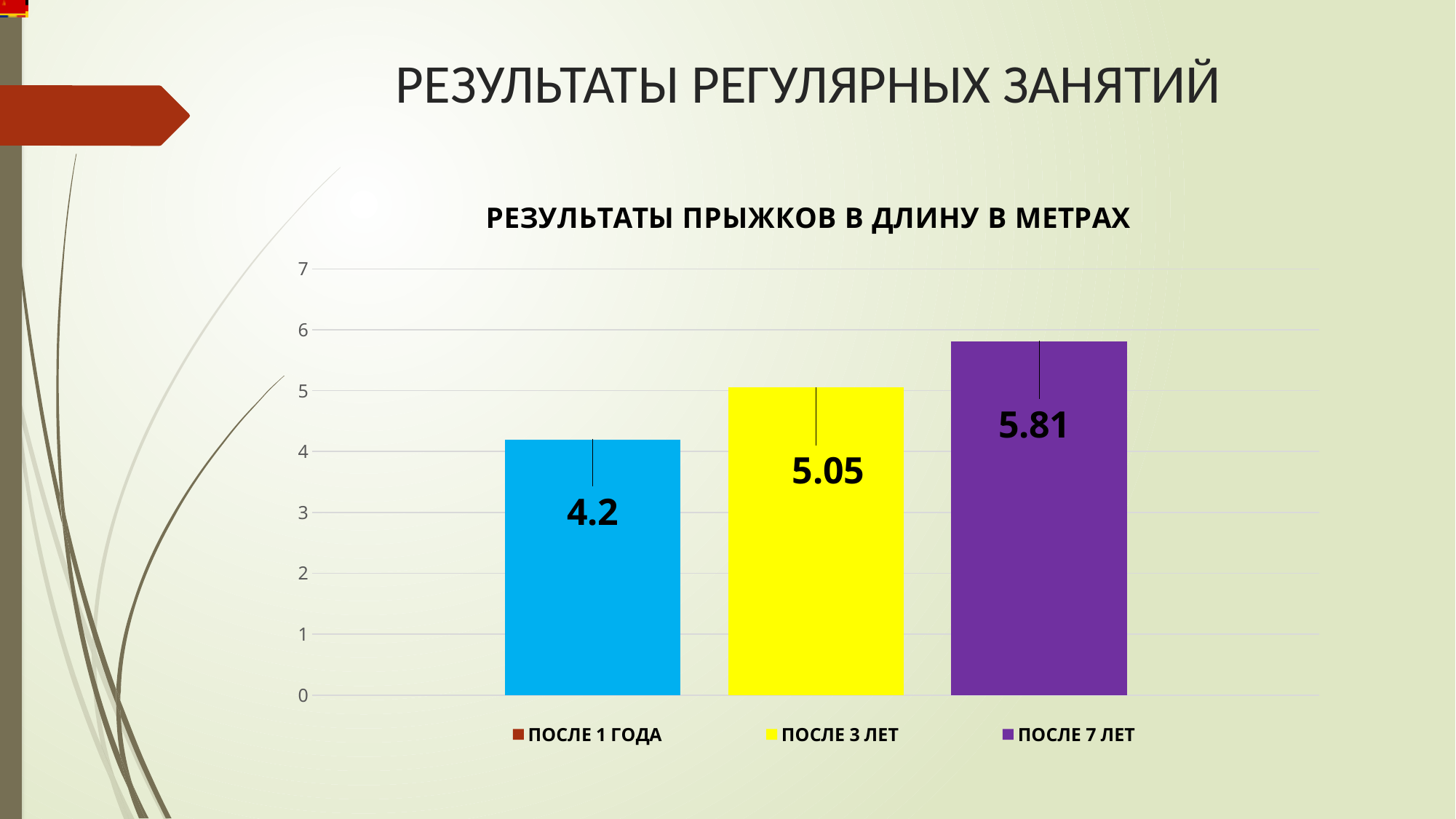
Which category has the highest value? ПОСЛЕ 7 ЛЕТ What is the value for ПОСЛЕ 7 ЛЕТ? 5.81 What is the value for ПОСЛЕ 1 ГОДА? 4.2 What is the difference between the values for ПОСЛЕ 7 ЛЕТ and ПОСЛЕ 1 ГОДА? 1.61 What is the difference between the values for ПОСЛЕ 3 ЛЕТ and ПОСЛЕ 1 ГОДА? 0.85 Is the value for ПОСЛЕ 7 ЛЕТ greater or less than 5? greater Which is larger, the value for ПОСЛЕ 3 ЛЕТ or the value for ПОСЛЕ 7 ЛЕТ? ПОСЛЕ 7 ЛЕТ Which category has the lowest value? ПОСЛЕ 1 ГОДА What is the value for ПОСЛЕ 3 ЛЕТ? 5.05 How many bars are shown in the chart? 3 What kind of chart is shown on the slide? bar chart What is the title of the chart? РЕЗУЛЬТАТЫ ПРЫЖКОВ В ДЛИНУ В МЕТРАХ